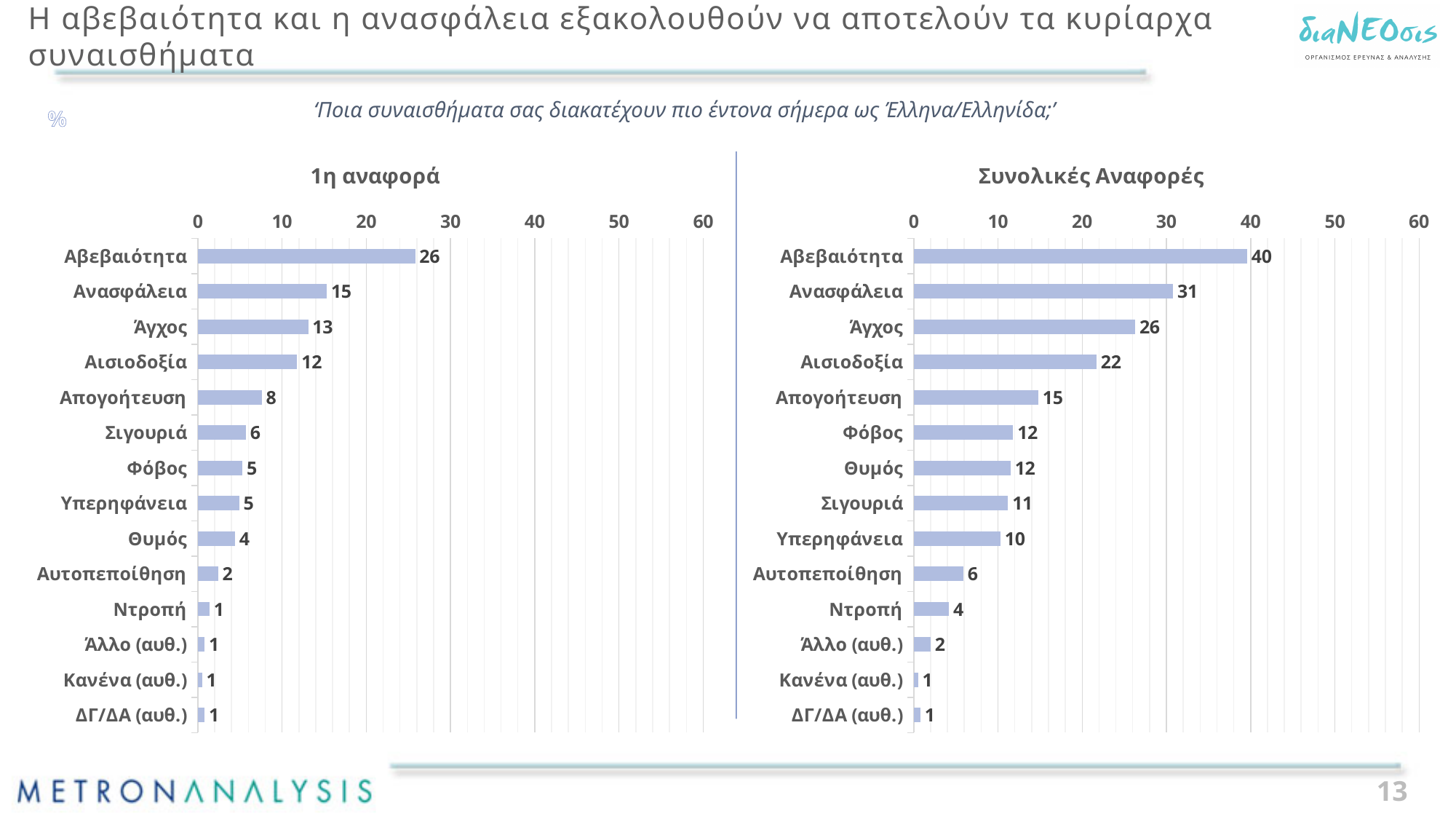
In the '1η αναφορά' chart, what is the difference between the values for Άγχος and Απογοήτευση? 5 In the 'Συνολικές Αναφορές' chart, which is larger, the value for Απογοήτευση or the value for Σιγουριά? Απογοήτευση What is the title of the chart on the right side of the slide? Συνολικές Αναφορές In the 'Συνολικές Αναφορές' chart, what is the difference between the values for Αβεβαιότητα and Ανασφάλεια? 9 How many categories are shown in the 'Συνολικές Αναφορές' chart? 14 In the '1η αναφορά' chart, which category has the lowest value among Αβεβαιότητα, Ανασφάλεια, Άγχος and Αισιοδοξία? Αισιοδοξία In the 'Συνολικές Αναφορές' chart, which category has the highest value? Αβεβαιότητα In the '1η αναφορά' chart, is the value for Αβεβαιότητα greater or less than 20? greater In the 'Συνολικές Αναφορές' chart, what is the value for Ανασφάλεια? 31 In the '1η αναφορά' chart, what is the value for Αβεβαιότητα? 26 In the 'Συνολικές Αναφορές' chart, what is the value for Θυμός? 12 What kind of chart is the '1η αναφορά' chart? bar chart